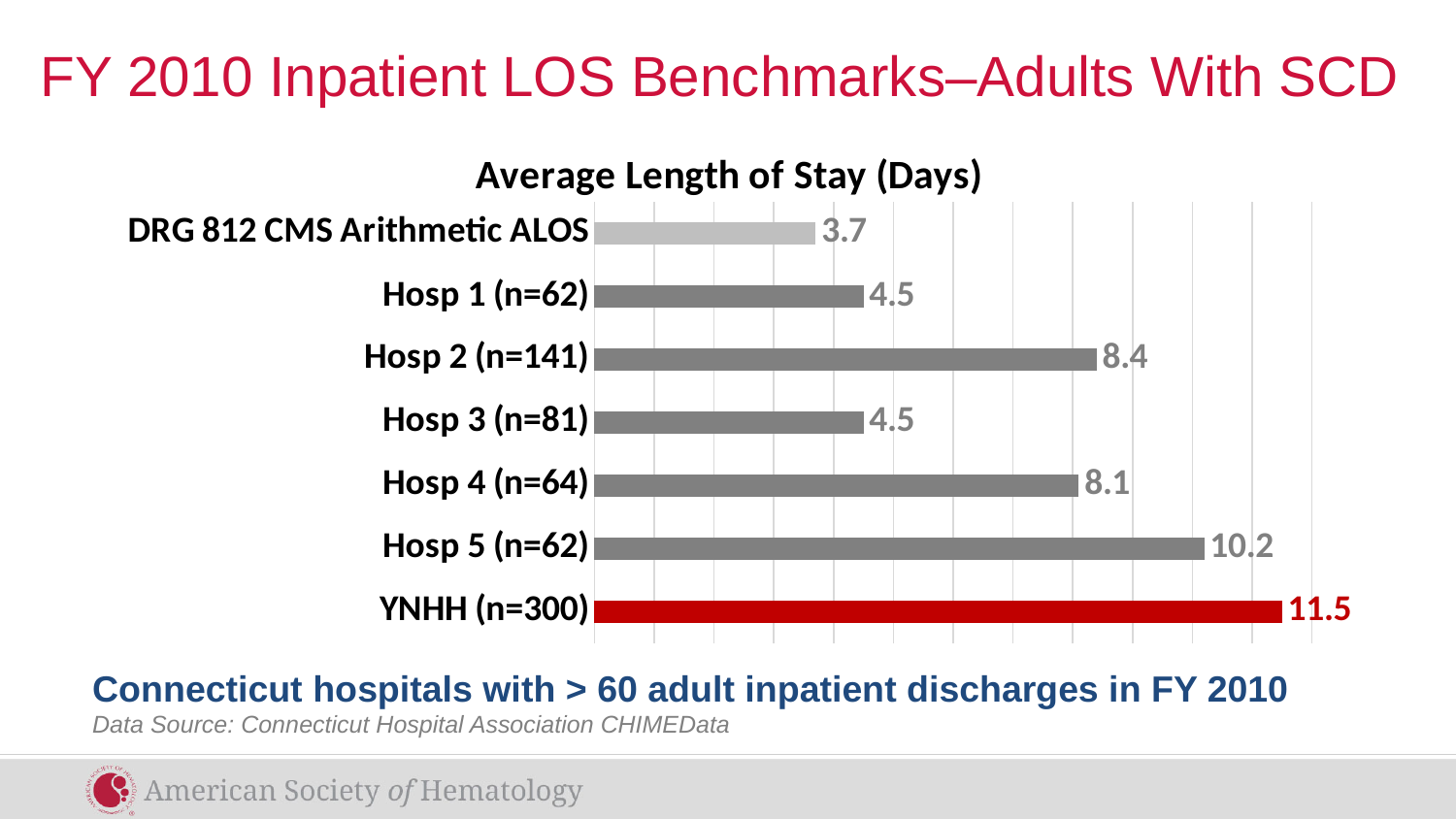
Which has a longer average length of stay, Hosp 4 (n=64) or Hosp 1 (n=62)? Hosp 4 (n=64) What is the average length of stay for Hosp 5 (n=62)? 10.2 Which category has the lowest average length of stay? DRG 812 CMS Arithmetic ALOS What is the difference in average length of stay between Hosp 2 (n=141) and Hosp 4 (n=64)? 0.3 Which category has the highest average length of stay? YNHH (n=300) What is the average length of stay for Hosp 2 (n=141)? 8.4 What is the difference in average length of stay between YNHH (n=300) and Hosp 5 (n=62)? 1.3 How many categories are shown in the chart? 7 What is the average length of stay for YNHH (n=300)? 11.5 What kind of chart is shown on the slide? Bar chart What is the title of the chart? Average Length of Stay (Days) What is the value shown for DRG 812 CMS Arithmetic ALOS? 3.7